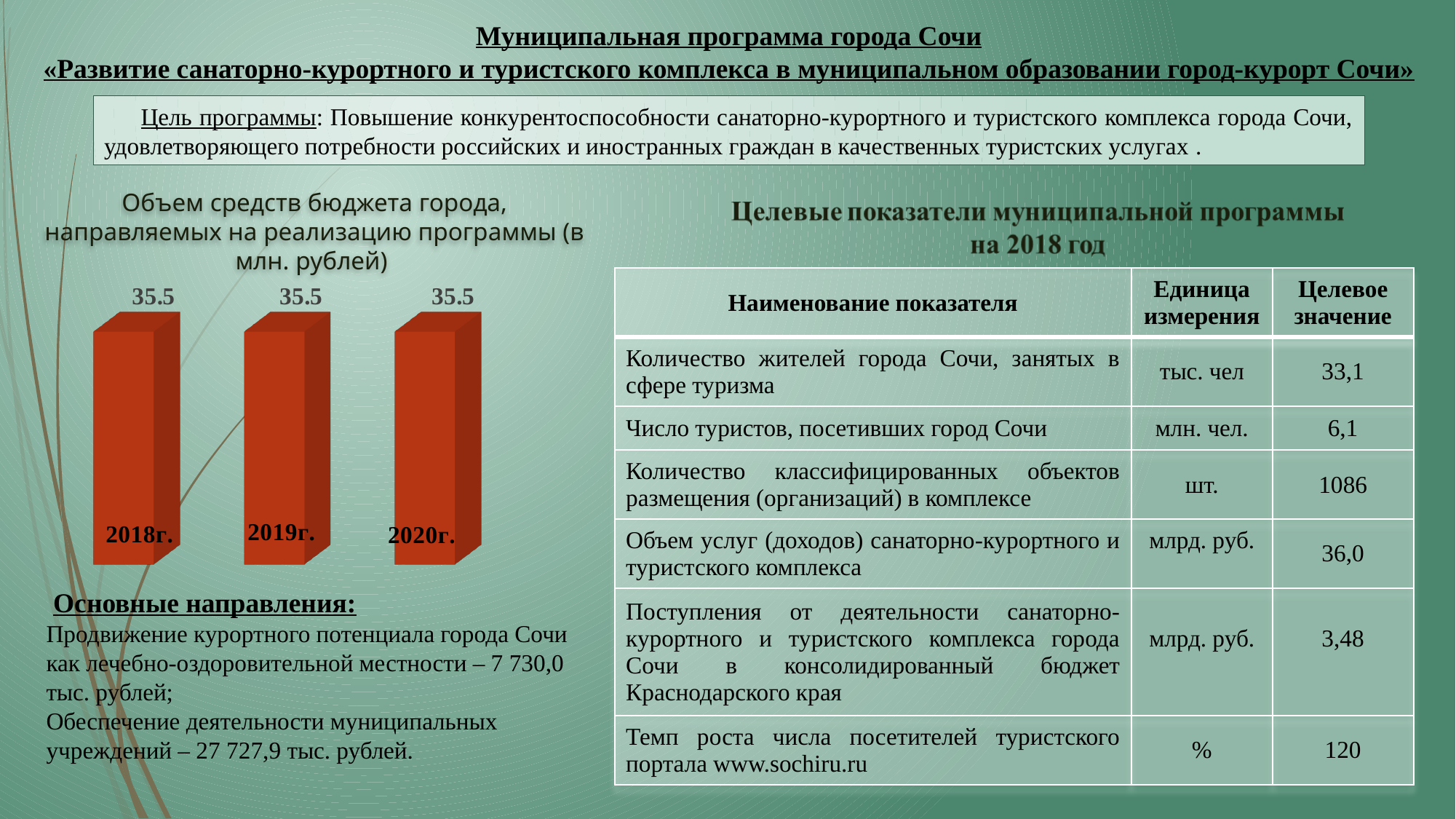
What is the value for 2019г. in the chart? 35.5 Which years are shown as categories in the chart? 2018г., 2019г., 2020г. What is the difference between the values for 2018г. and 2020г.? 0 What is the value for 2020г. in the chart? 35.5 Is the value for 2019г. larger than, smaller than, or equal to the value for 2018г.? Equal What is the title of the chart? Объем средств бюджета города, направляемых на реализацию программы (в млн. рублей) What is the value for 2018г. in the chart? 35.5 What kind of chart is shown on the slide? Bar chart Do the values rise, fall, or stay the same from 2018г. to 2020г.? Stay the same In what units are the chart values expressed, according to its title? млн. рублей How many bars (categories) are shown in the chart? 3 What colour are the bars in the chart? Red